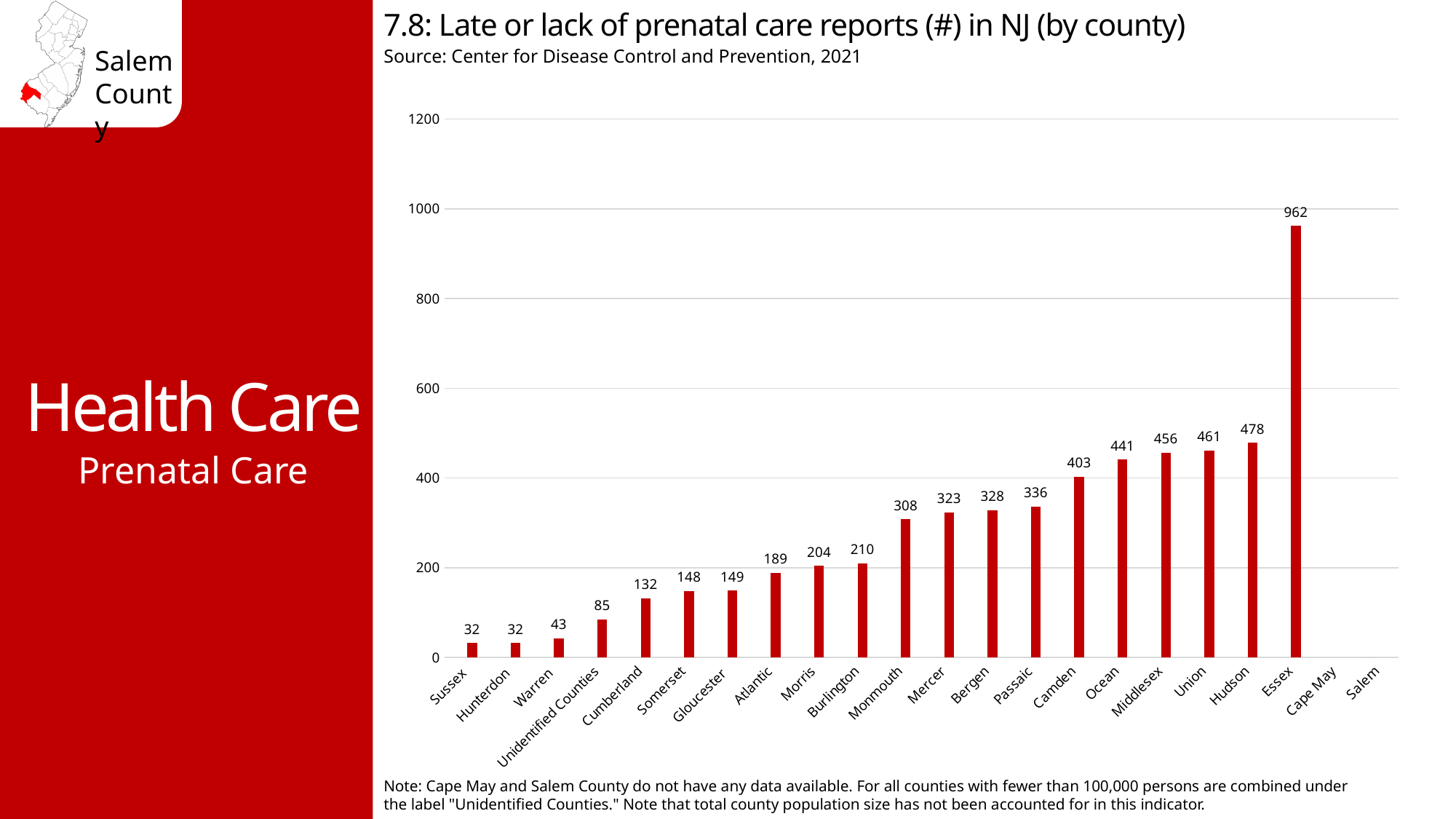
What is the value shown for Unidentified Counties? 85 What is the value shown for Camden? 403 Which county has the highest number of late or lack of prenatal care reports? Essex What is the value shown for Cumberland? 132 What is the difference between the values for Camden and Passaic? 67 What kind of chart is shown on the slide? Bar chart Is the value for Monmouth greater or less than 200? greater What is the number of late or lack of prenatal care reports for Essex? 962 Which has a larger value, Ocean or Middlesex? Middlesex How many county labels are shown on the x axis? 22 Do the bar values generally rise or fall from left to right along the x axis? Rise What is the difference between the values for Essex and Hudson? 484